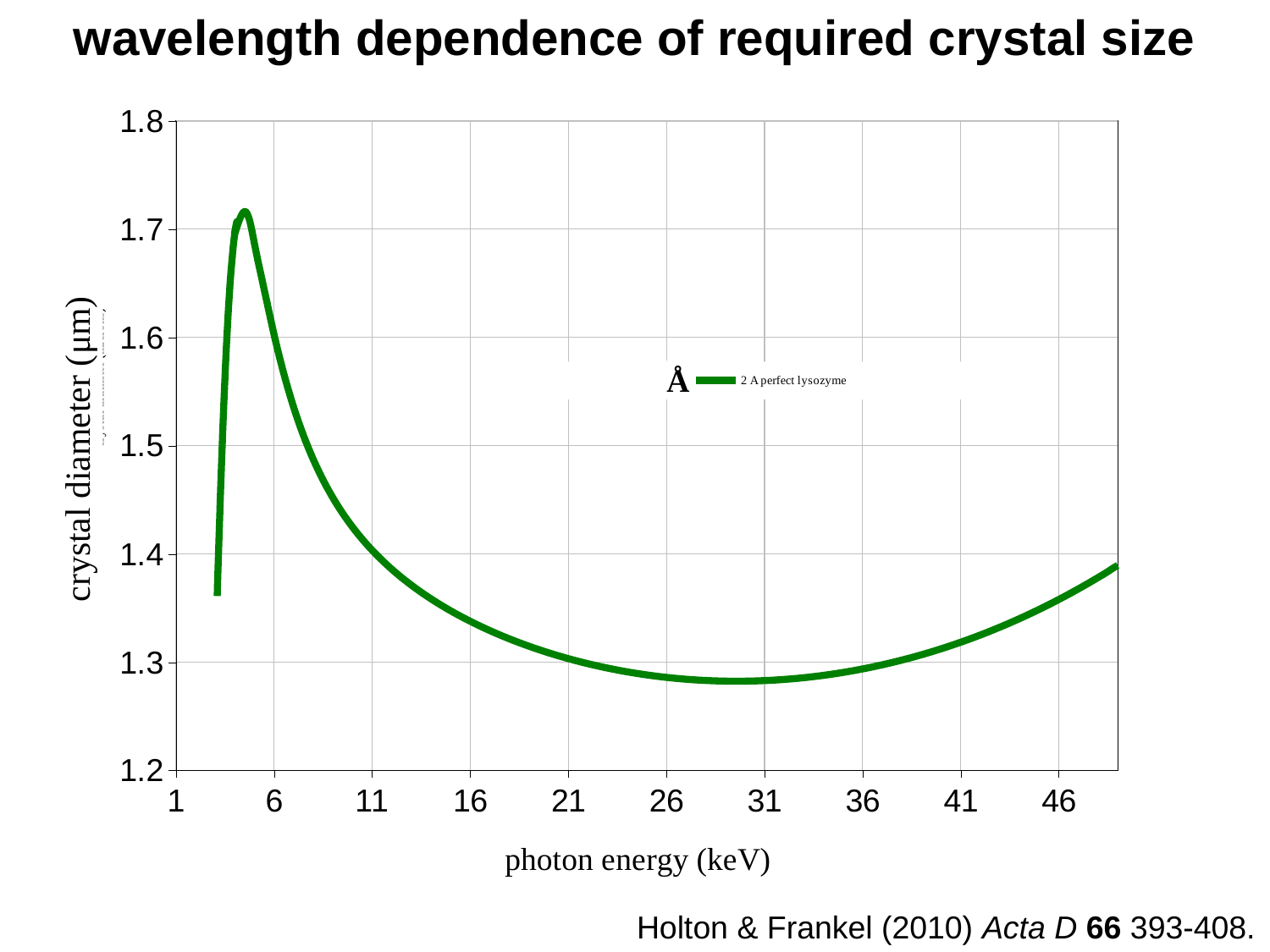
What series name is shown in the legend? 2 A perfect lysozyme Which is larger, the crystal diameter at 11 keV or at 26 keV? 11 keV Is the crystal diameter at a photon energy of 31 keV greater or less than 1.3 μm? less Is the crystal diameter at a photon energy of 46 keV greater or less than 1.4 μm? less How many series does the legend list? 1 Is the crystal diameter at a photon energy of 16 keV greater or less than 1.4 μm? less What kind of chart is shown on the slide? line chart What is the title of the chart? wavelength dependence of required crystal size Does the crystal diameter rise or fall as photon energy increases from 31 keV to 46 keV? rise Does the crystal diameter rise or fall as photon energy increases from 6 keV to 26 keV? fall